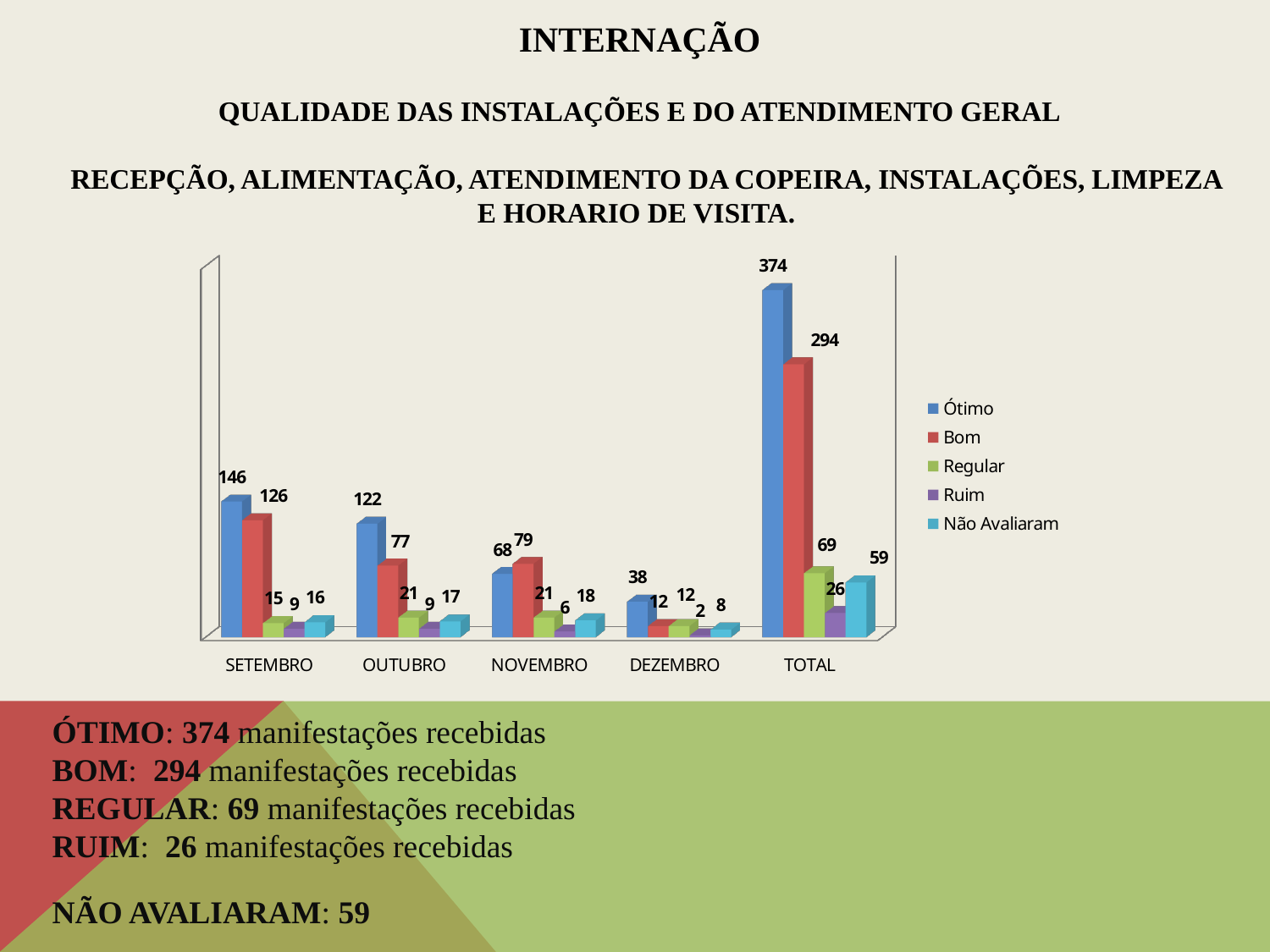
What is the value for Não Avaliaram in TOTAL? 59 Which month (excluding TOTAL) has the highest value for Ótimo? SETEMBRO What is the value for Ruim in DEZEMBRO? 2 What is the value for Ótimo in SETEMBRO? 146 How many series does the legend list? 5 How many categories are shown on the x axis? 5 What is the difference between the Ótimo and Bom values in TOTAL? 80 Which month (excluding TOTAL) has the lowest value for Bom? DEZEMBRO What is the value for Bom in OUTUBRO? 77 What kind of chart is shown on the slide? Bar chart What is the value for Regular in NOVEMBRO? 21 In NOVEMBRO, which is larger, Ótimo or Bom? Bom